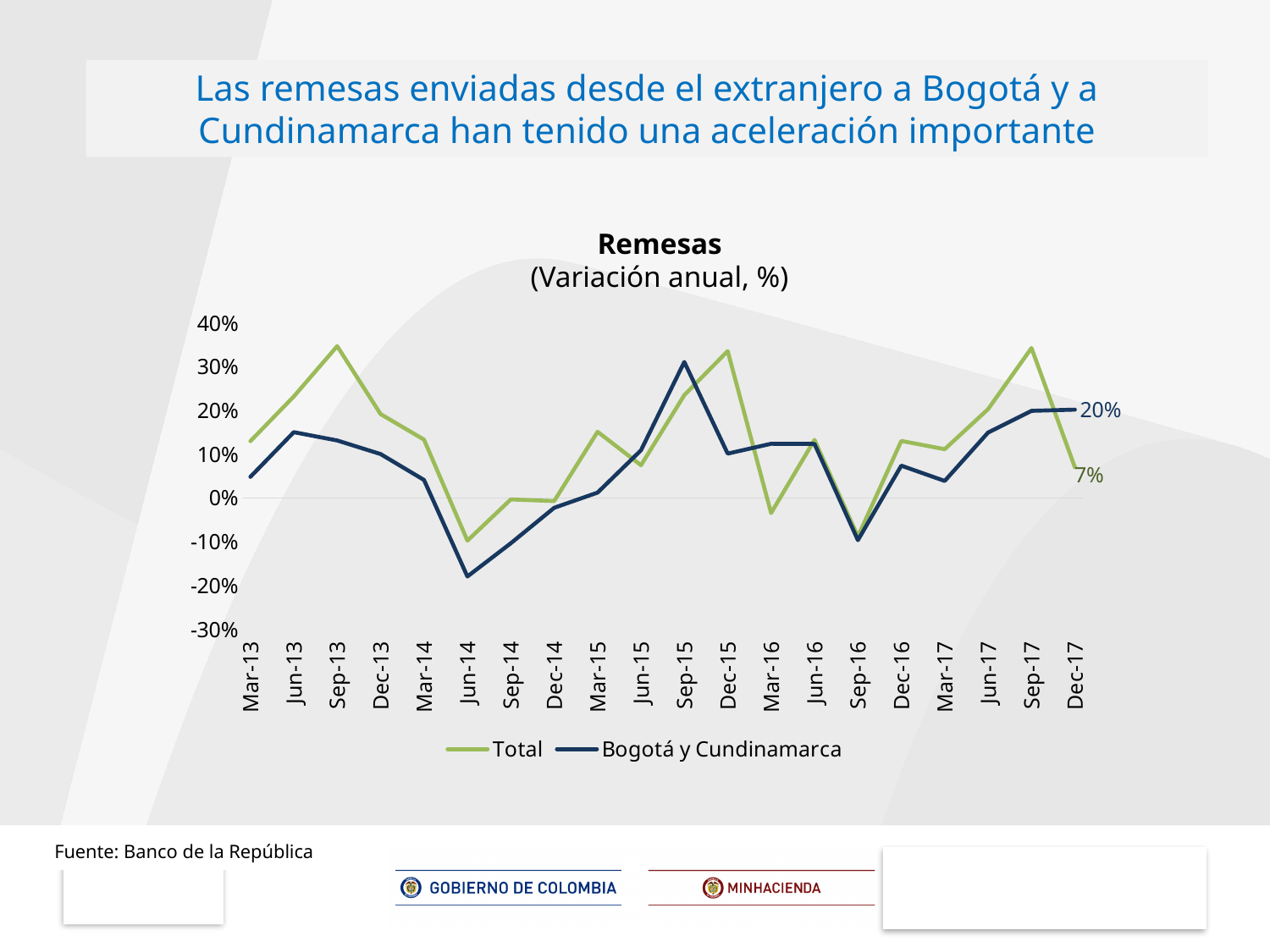
How many series does the legend list? 2 What is the title of the chart? Remesas (Variación anual, %) What is the value for Bogotá y Cundinamarca at Dec-17? 20% At which date does the Bogotá y Cundinamarca series reach its lowest value? Jun-14 What is the value for Total at Dec-17? 7% At which date does the Bogotá y Cundinamarca series reach its highest value? Sep-15 What is the difference between the Bogotá y Cundinamarca value and the Total value at Dec-17? 13 percentage points Is the value for Total at Sep-13 greater or less than 30%? greater What type of chart is shown on the slide? Line chart How many dates are plotted along the x axis? 20 Is the value for Bogotá y Cundinamarca at Jun-14 greater or less than -10%? less At Dec-17, which series has the higher value, Total or Bogotá y Cundinamarca? Bogotá y Cundinamarca